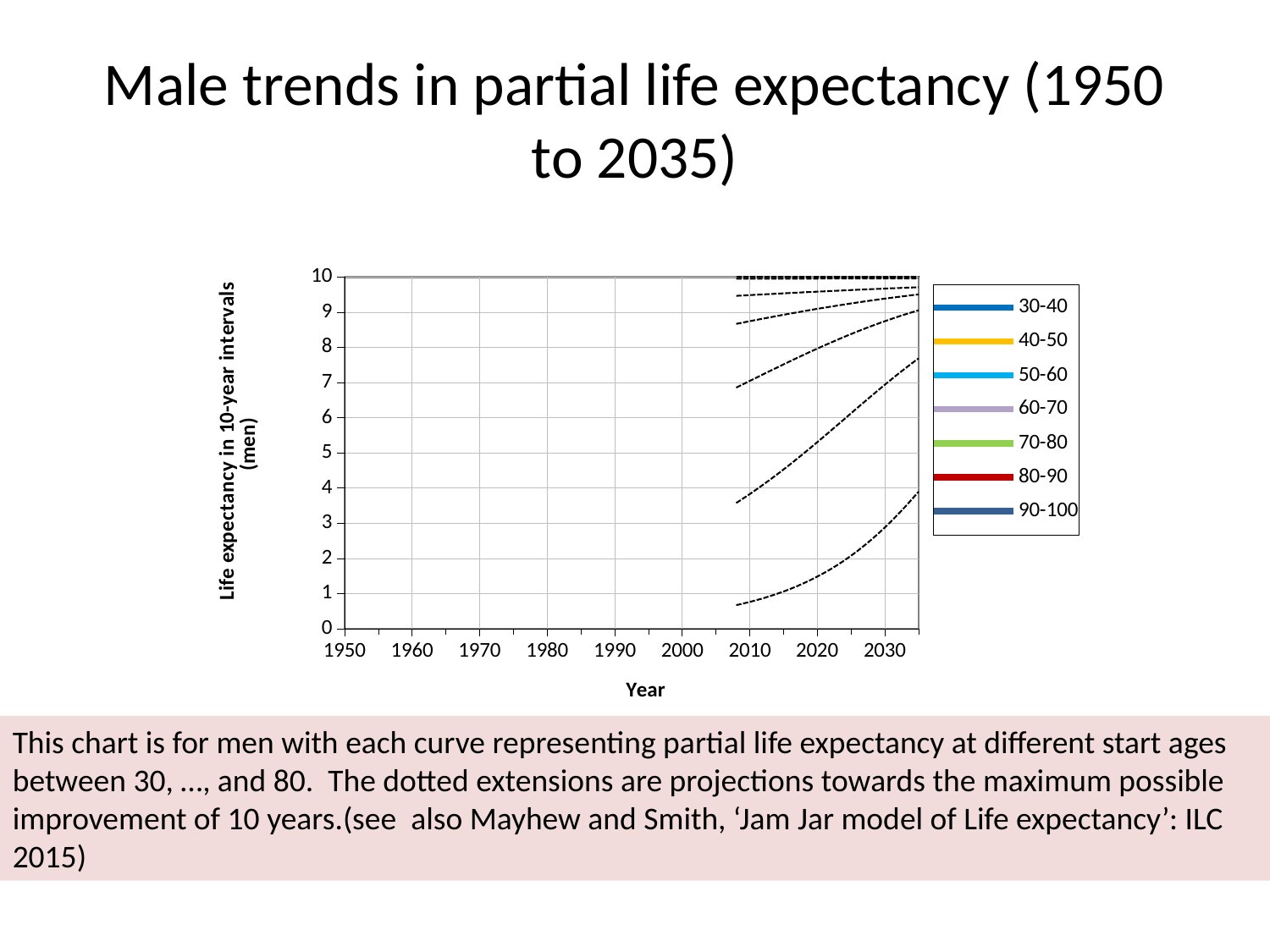
Is the value of the lowest dotted curve at 2020 greater or less than 2? less Is the value of the lowest dotted curve at 2010 greater or less than 1? less Which age interval is listed last in the legend? 90-100 How many series does the legend list? 7 What type of chart is shown on the slide? Line chart Is the value of the lowest dotted curve at 2030 greater or less than 2? greater Do the dotted projection curves rise or fall as the year increases from 2010 to 2035? Rise What is the title of the vertical axis? Life expectancy in 10-year intervals (men)